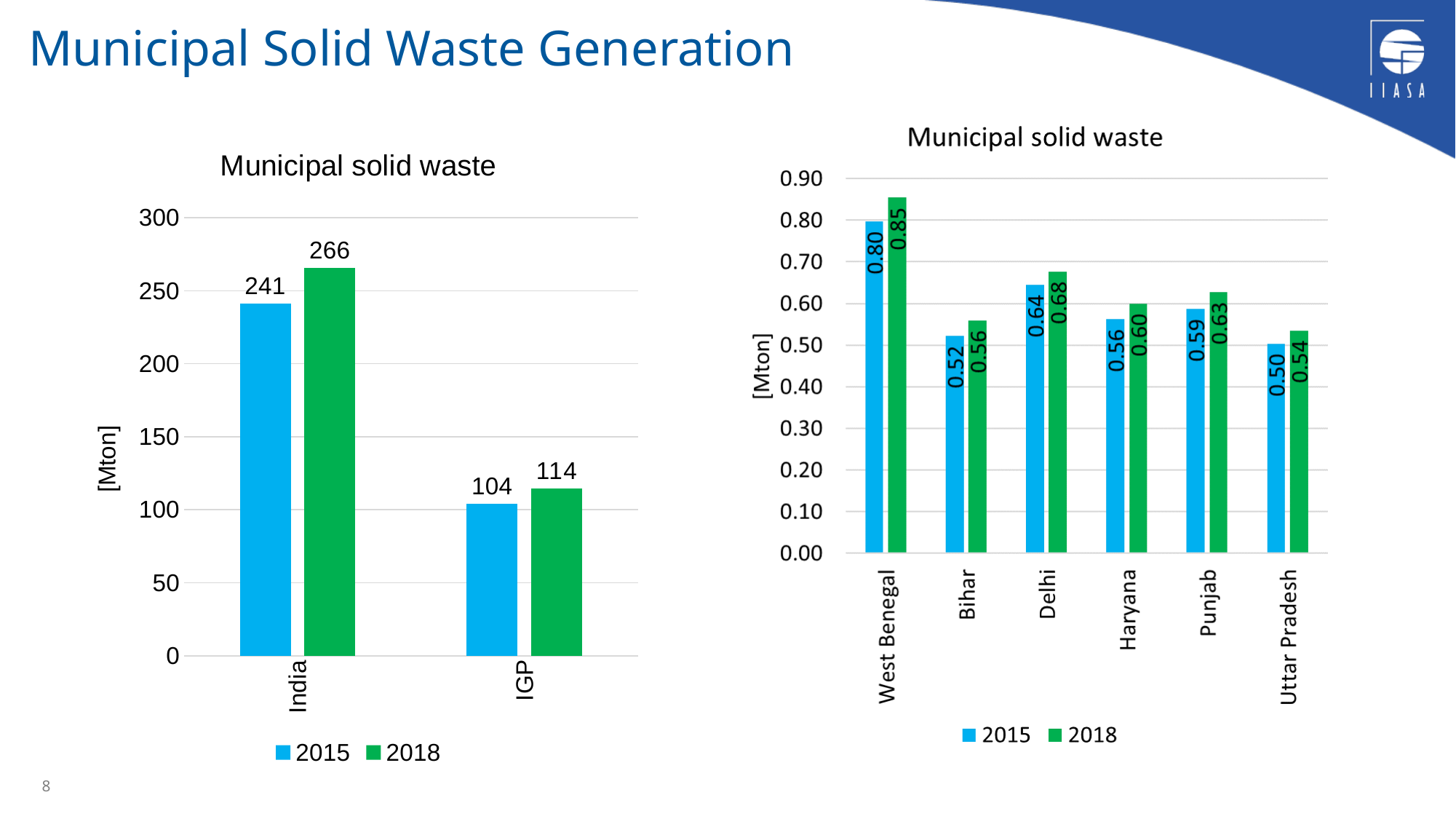
In the left chart, what is the difference between the 2018 and 2015 values for India? 25 In the right chart, which state has the highest 2018 value? West Benegal In the left chart, what is the value for IGP in 2015? 104 In the right chart, what is the 2015 value for Uttar Pradesh? 0.50 In the right chart, which state has the lowest 2015 value? Uttar Pradesh In the left chart, what is the value for India in 2018? 266 In the right chart, what is the 2018 value for Delhi? 0.68 In the left chart, what kind of chart is shown? Bar chart In the left chart, how many categories are shown on the x axis? 2 In the right chart, what is the difference between the 2018 and 2015 values for Punjab? 0.04 In the right chart, what is the label on the y axis? [Mton] In the right chart, how many series does the legend list? 2